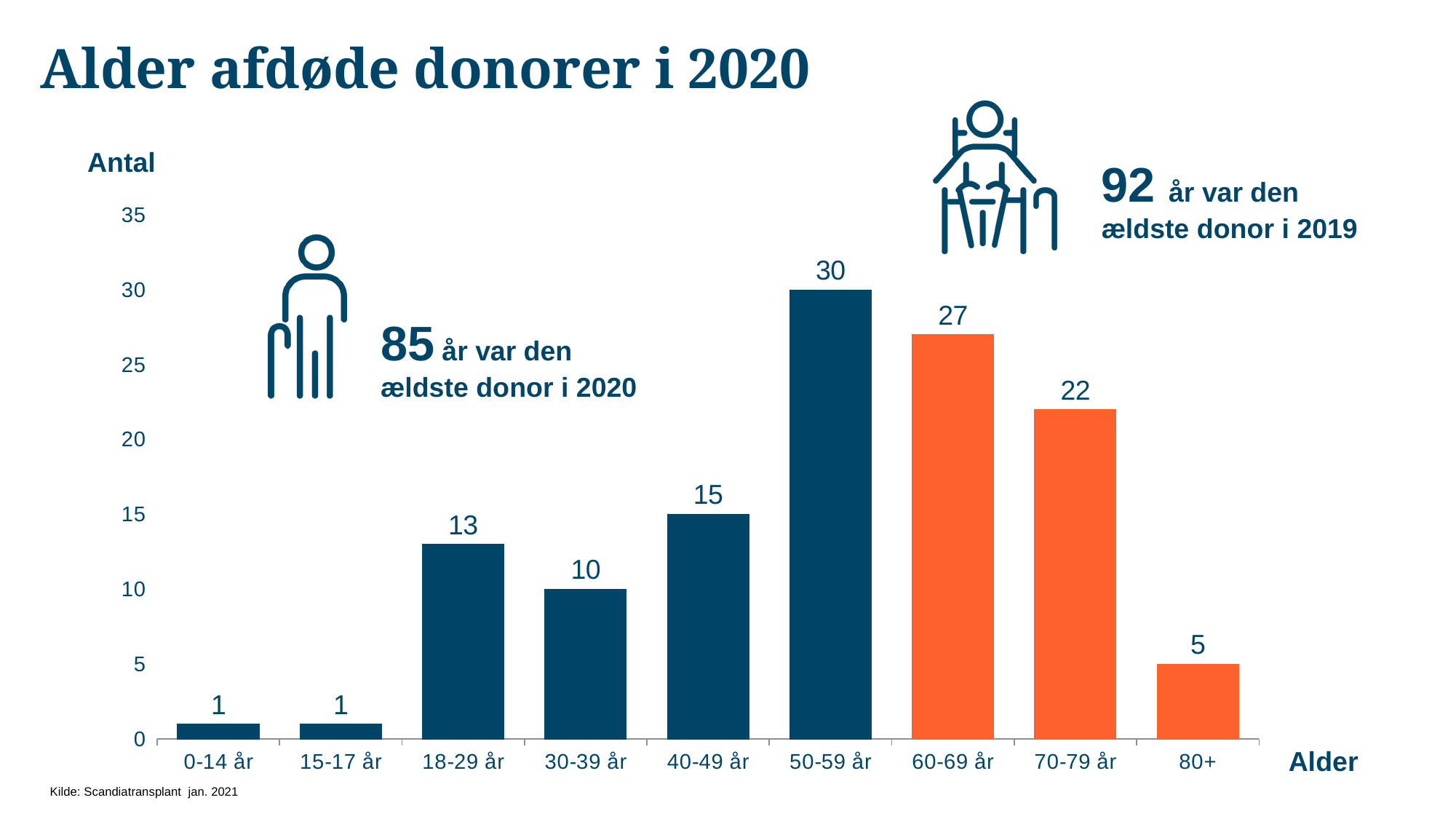
What is the value for the 50-59 år age group? 30 What kind of chart is shown on the slide? bar chart Which age group has the highest value? 50-59 år What is the value for the 80+ age group? 5 What is the total of the values for 0-14 år and 15-17 år? 2 What is the value for the 18-29 år age group? 13 Do the values rise or fall from 50-59 år to 80+? fall Which is larger, the value for 40-49 år or the value for 30-39 år? 40-49 år What is the title of the chart? Alder afdøde donorer i 2020 What is the difference between the values for 60-69 år and 70-79 år? 5 Is the value for 60-69 år greater or less than 25? greater How many age groups are shown on the x axis? 9